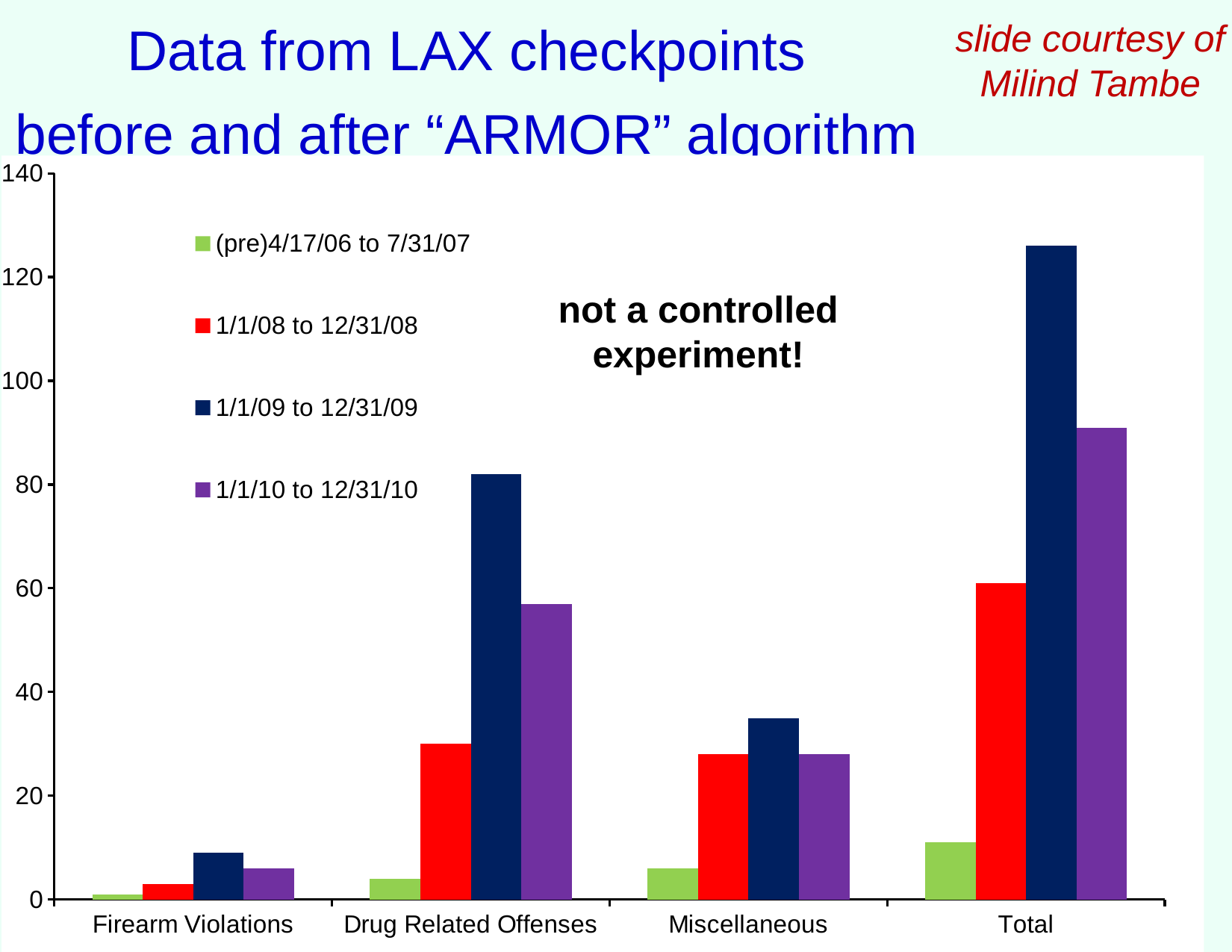
How many series does the legend list? 4 Is the value for Miscellaneous in the 1/1/09 to 12/31/09 series greater or less than 40? less What kind of chart is shown on the slide? bar chart For Drug Related Offenses, which series has the larger value: 1/1/09 to 12/31/09 or 1/1/10 to 12/31/10? 1/1/09 to 12/31/09 Which category has the highest value for the 1/1/09 to 12/31/09 series? Total How many categories are shown on the x axis? 4 Is the value for Firearm Violations in the 1/1/09 to 12/31/09 series greater or less than 20? less Which category has the lowest value for the (pre)4/17/06 to 7/31/07 series? Firearm Violations Is the value for Total in the 1/1/10 to 12/31/10 series greater or less than 80? greater What is the title of the slide containing the chart? Data from LAX checkpoints before and after "ARMOR" algorithm Which series is shown in red in the legend? 1/1/08 to 12/31/08